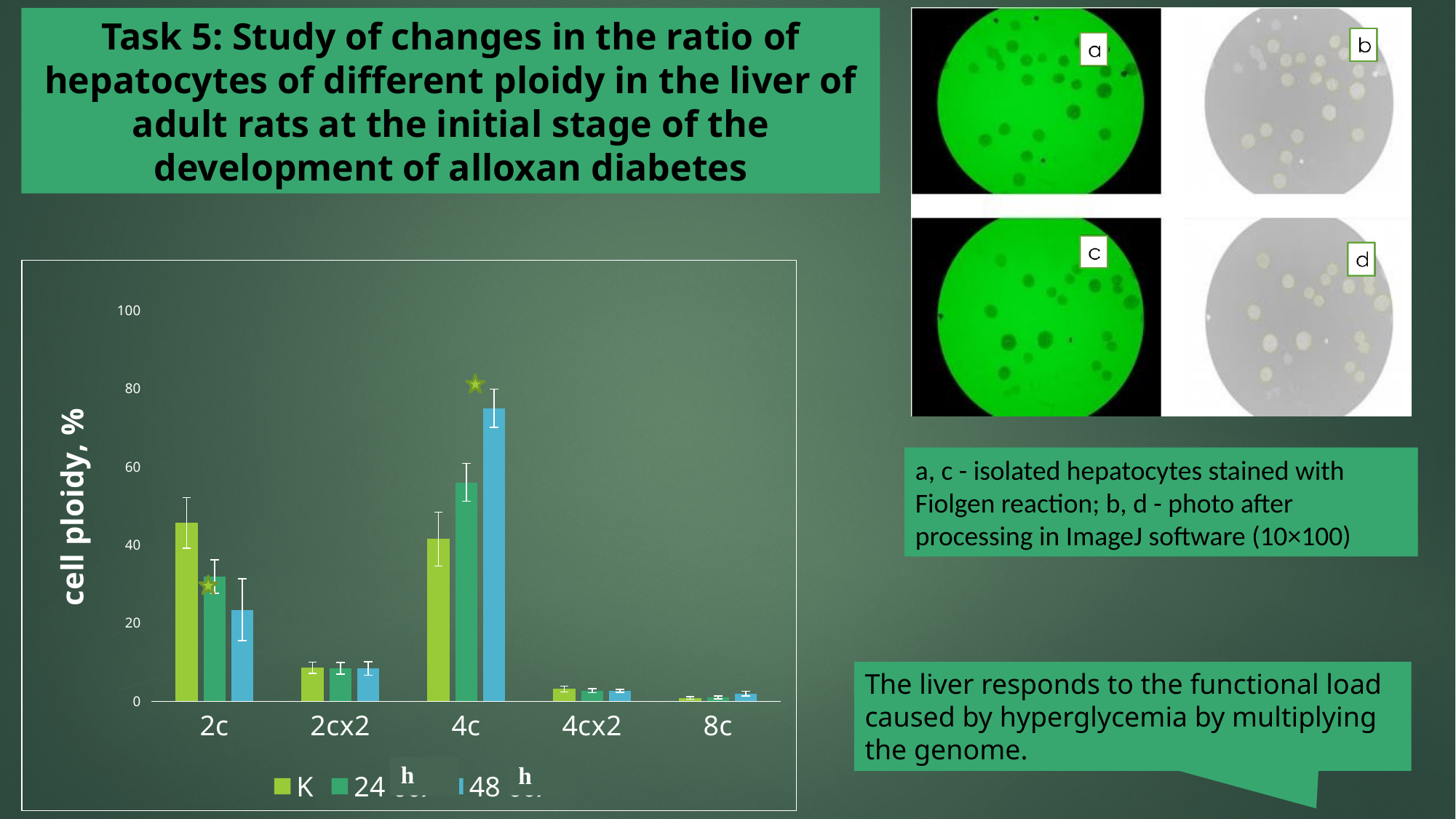
Is the value for 24 h in the 2cx2 category greater or less than 20? less Is the value for K in the 2c category greater or less than 40? greater For the 48 h series, which category has the highest value? 4c Which series is shown in blue in the chart? 48 h How many categories are shown on the x axis of the chart? 5 How many series does the chart legend list? 3 Is the value for 48 h in the 4c category greater or less than 60? greater What kind of chart is shown on the slide? bar chart In the 2c category, which series has the higher value: K or 24 h? K In the 4c category, which series has the higher value: K or 48 h? 48 h What is the label of the y axis of the chart? cell ploidy, %